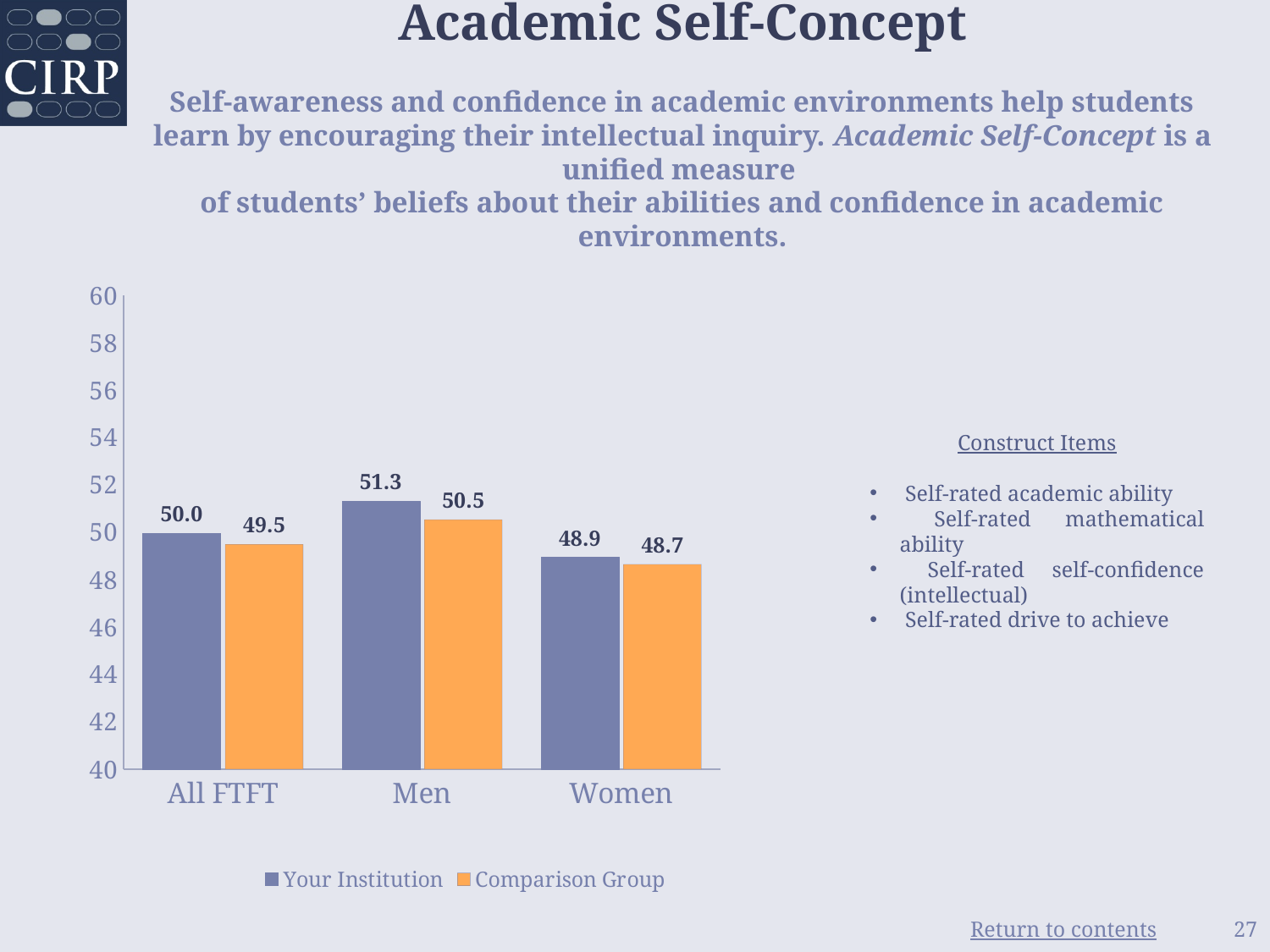
Which category has the lowest value for the Comparison Group? Women Which is larger for Men: Your Institution or the Comparison Group? Your Institution What is the difference between Your Institution and the Comparison Group in the Men category? 0.8 How many series does the legend list? 2 Which series is shown in orange in the legend? Comparison Group What kind of chart is shown on the slide? Bar chart Which category has the highest value for Your Institution? Men What is the value for Your Institution in the Men category? 51.3 What is the value for the Comparison Group in the Women category? 48.7 What is the value for Your Institution in the All FTFT category? 50.0 What is the difference between Your Institution and the Comparison Group in the All FTFT category? 0.5 How many categories are shown on the x axis? 3